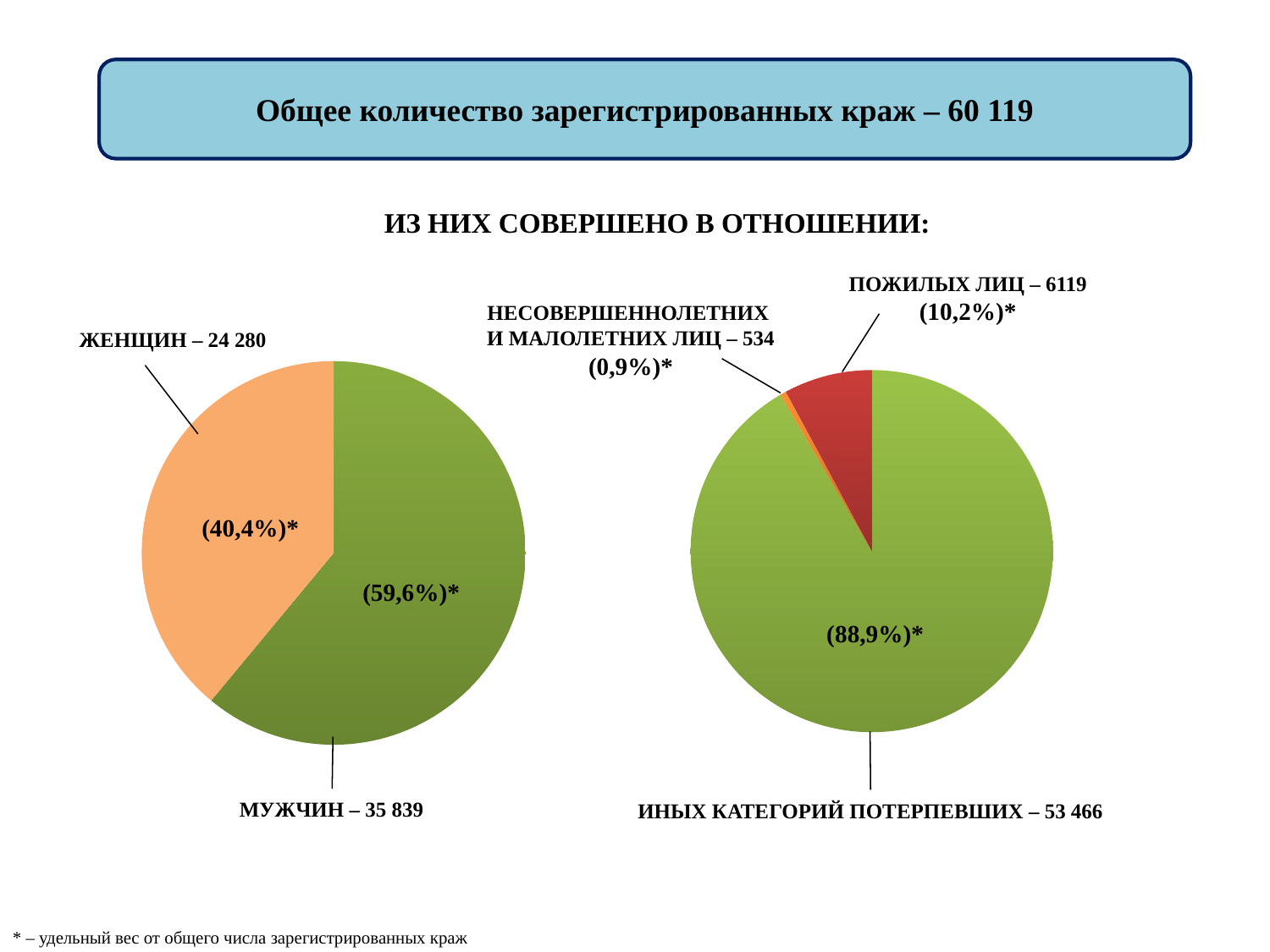
How many slices does the right pie chart have? 3 In the left pie chart, how many thefts were committed against women (ЖЕНЩИН)? 24 280 In the left pie chart, what share of the total do thefts against men (МУЖЧИН) represent? 59,6% In the right pie chart, which category has the smallest slice? НЕСОВЕРШЕННОЛЕТНИХ И МАЛОЛЕТНИХ ЛИЦ What type of chart is shown on the left of the slide? Pie chart In the right pie chart, how many thefts were committed against minors (НЕСОВЕРШЕННОЛЕТНИХ И МАЛОЛЕТНИХ ЛИЦ)? 534 In the left pie chart, how many thefts were committed against men (МУЖЧИН)? 35 839 In the right pie chart, what share of the total do thefts against other categories of victims (ИНЫХ КАТЕГОРИЙ ПОТЕРПЕВШИХ) represent? 88,9% In the right pie chart, how many thefts were committed against elderly persons (ПОЖИЛЫХ ЛИЦ)? 6119 In the left pie chart, which category has the larger slice, ЖЕНЩИН or МУЖЧИН? МУЖЧИН In the left pie chart, what share of the total do thefts against women (ЖЕНЩИН) represent? 40,4% In the left pie chart, what is the difference between the number of thefts against men and against women? 11 559